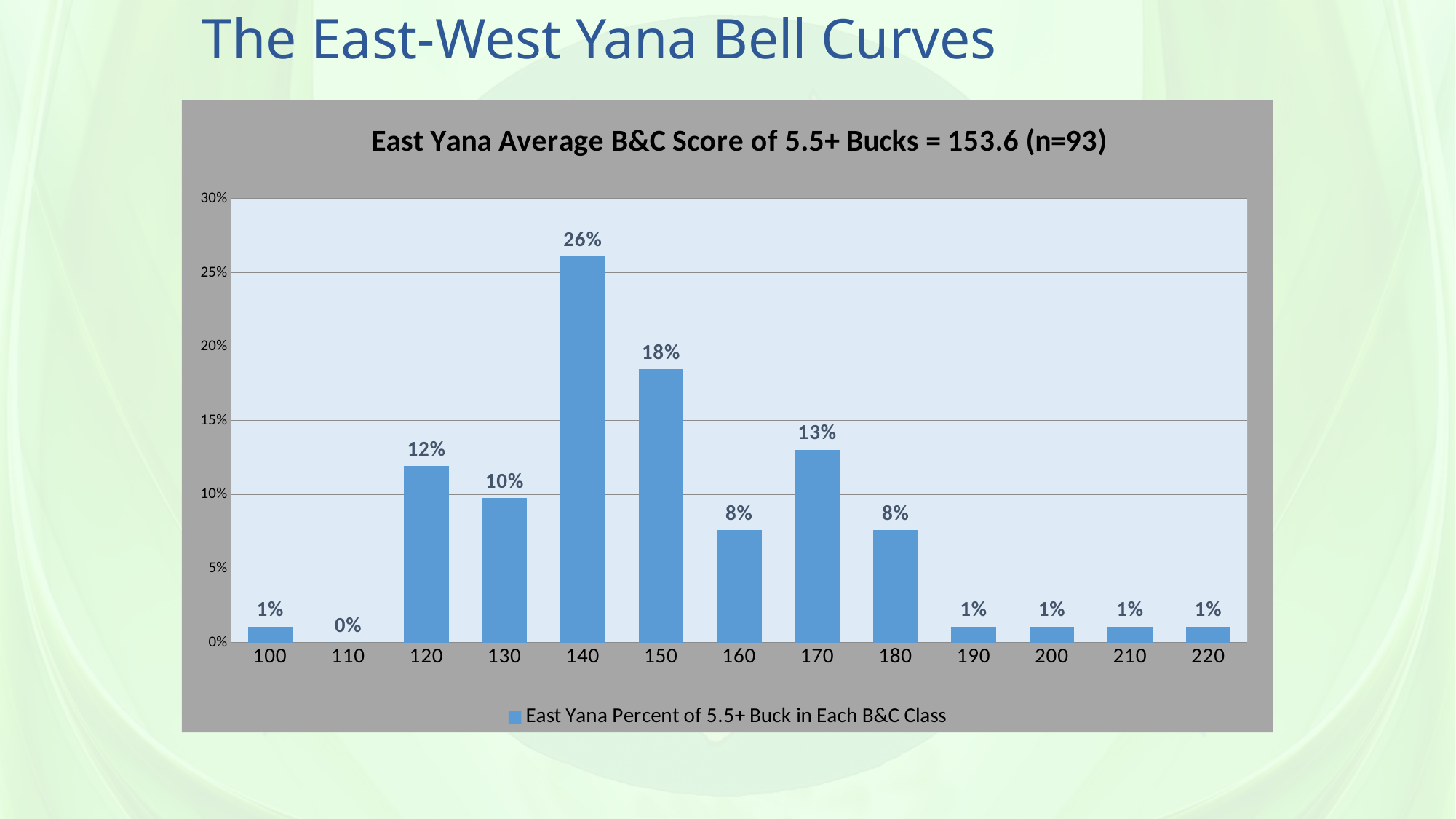
How many series does the legend list? 1 What is the value for the 110 B&C class? 0% Which B&C class has the highest percentage? 140 What is the chart's title? East Yana Average B&C Score of 5.5+ Bucks = 153.6 (n=93) Is the value for the 130 class greater or less than 15%? less Which is larger, the value for 120 or the value for 170? 170 How many B&C classes are shown on the x axis? 13 What is the value for the 150 B&C class? 18% What is the difference between the values for the 140 and 150 classes? 8% What kind of chart is shown? bar chart What is the value for the 140 B&C class? 26% Which B&C class has the lowest percentage? 110